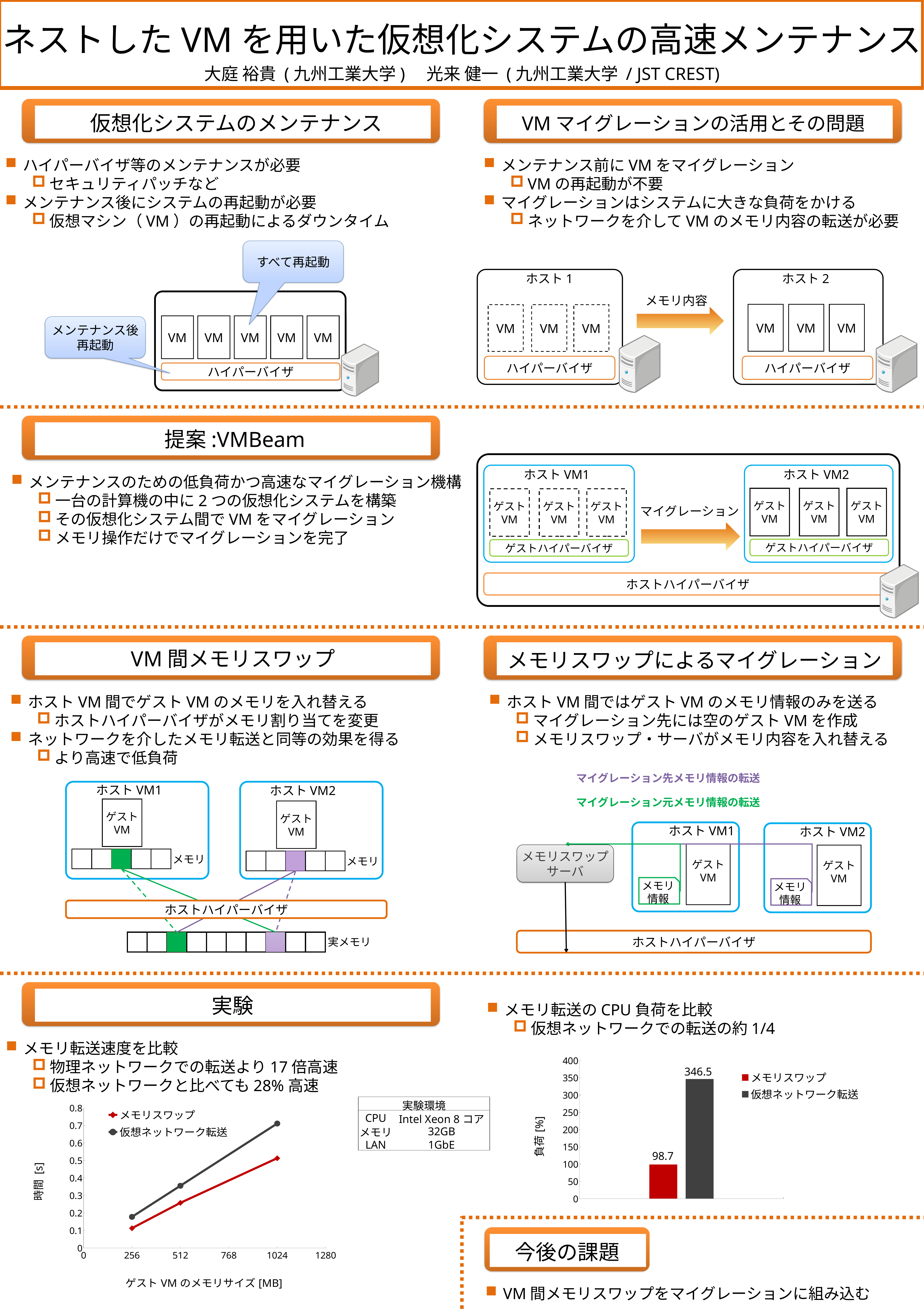
In the line chart on the bottom left, how many series does the legend list? 2 In the line chart on the bottom left, do the values for 仮想ネットワーク転送 rise or fall as the memory size increases? rise In the line chart on the bottom left, is the value for 仮想ネットワーク転送 at 1024 MB greater or less than 0.6? greater In the bar chart on the bottom right, what is the label of the y axis? 負荷 [%] In the bar chart on the bottom right, what is the difference between the 仮想ネットワーク転送 value and the メモリスワップ value? 247.8 What kind of chart is the chart on the bottom left of the slide? line chart In the bar chart on the bottom right, how many bars are plotted? 2 In the bar chart on the bottom right, what is the value for 仮想ネットワーク転送? 346.5 In the line chart on the bottom left, which series has the larger value at 512 MB, メモリスワップ or 仮想ネットワーク転送? 仮想ネットワーク転送 In the bar chart on the bottom right, which category has the higher 負荷 [%]? 仮想ネットワーク転送 In the line chart on the bottom left, is the value for メモリスワップ at 1024 MB greater or less than 0.6? less In the bar chart on the bottom right, what is the value for メモリスワップ? 98.7